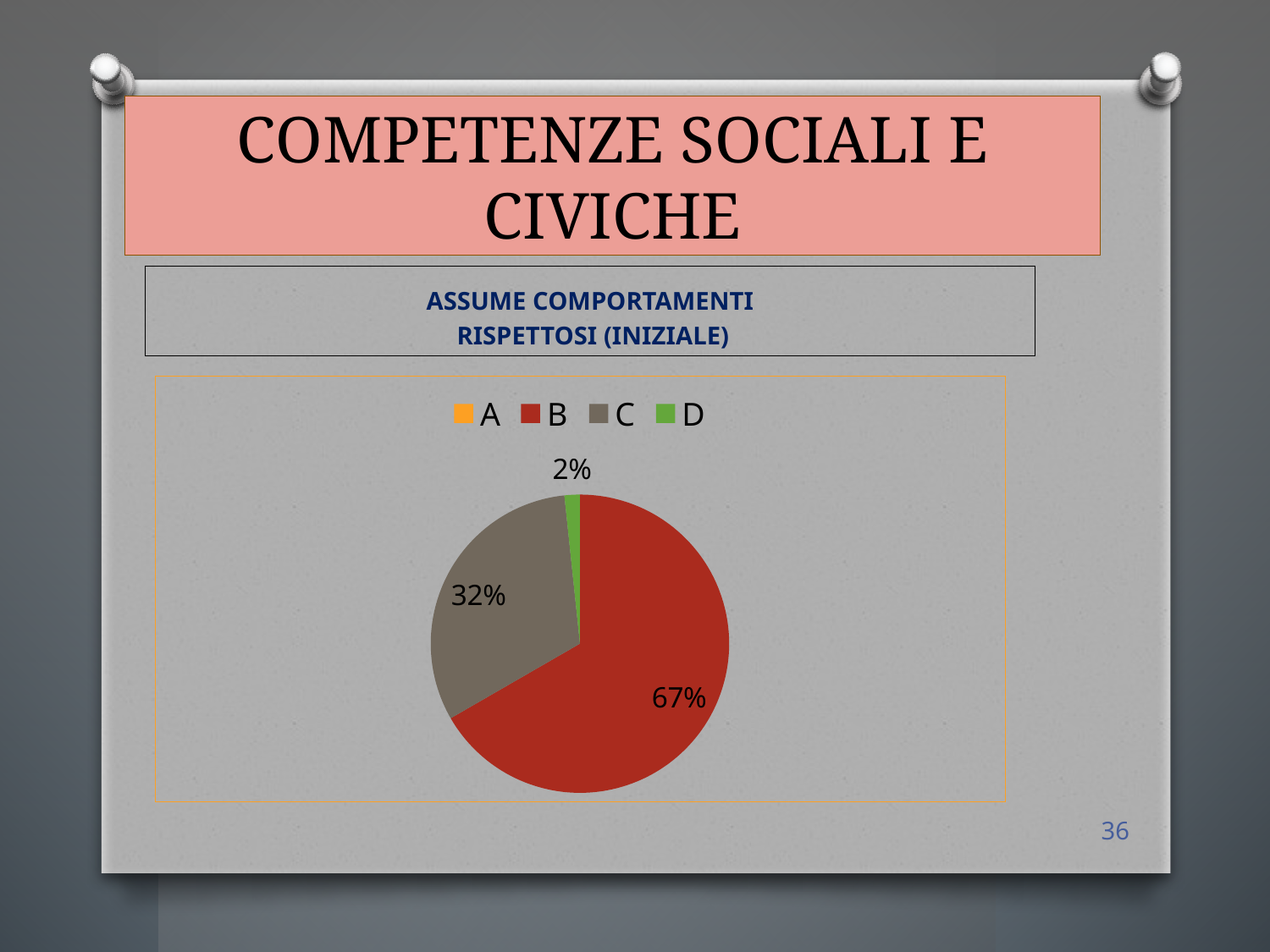
What is the difference in percentage points between slice B and slice C? 35% What kind of chart is shown on the slide? Pie chart How many entries does the legend of the pie chart list? 4 What percentage does slice C represent in the pie chart? 32% What percentage does slice D represent in the pie chart? 2% What share of the pie does slice B take? 67% What is the title shown in the box above the pie chart? ASSUME COMPORTAMENTI RISPETTOSI (INIZIALE) Which of the labelled slices in the pie chart is the smallest? D Which slice is larger, C or D? C What percentage does slice B represent in the pie chart? 67% Which category has the largest slice in the pie chart? B What colour is slice B in the pie chart? Red